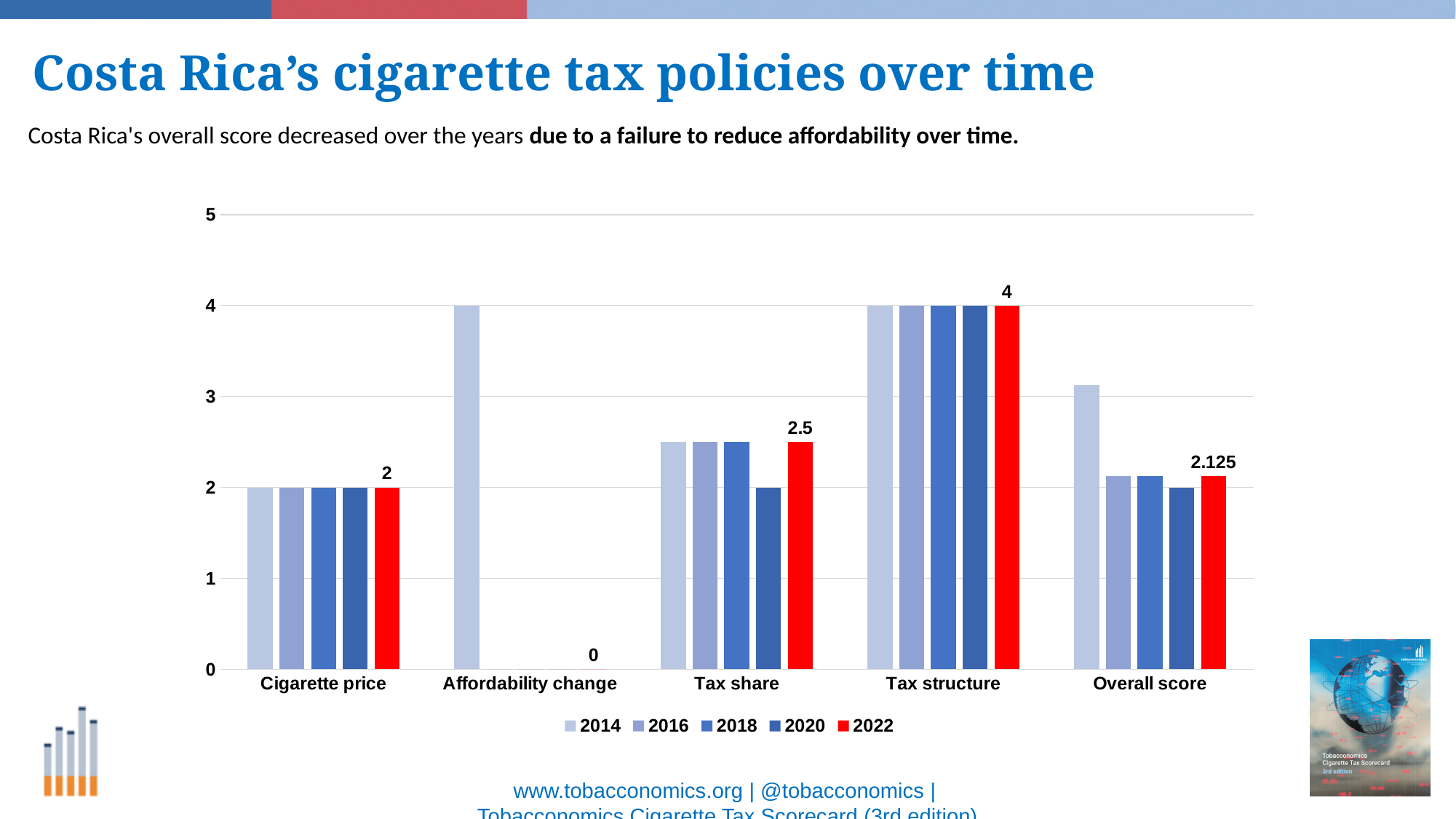
What is the 2022 value for Affordability change? 0 What is the difference between the 2022 values for Tax structure and Tax share? 1.5 What is the 2022 value for Tax structure? 4 What is the 2022 value for Tax share? 2.5 What colour are the 2022 bars? red What is the 2014 value for Affordability change? 4 What is the 2022 value for Overall score? 2.125 Which category has the highest 2022 value? Tax structure How many categories are shown on the x axis? 5 How many series does the legend list? 5 Is the 2014 value for Overall score greater or less than 3? greater What kind of chart is shown on the slide? bar chart